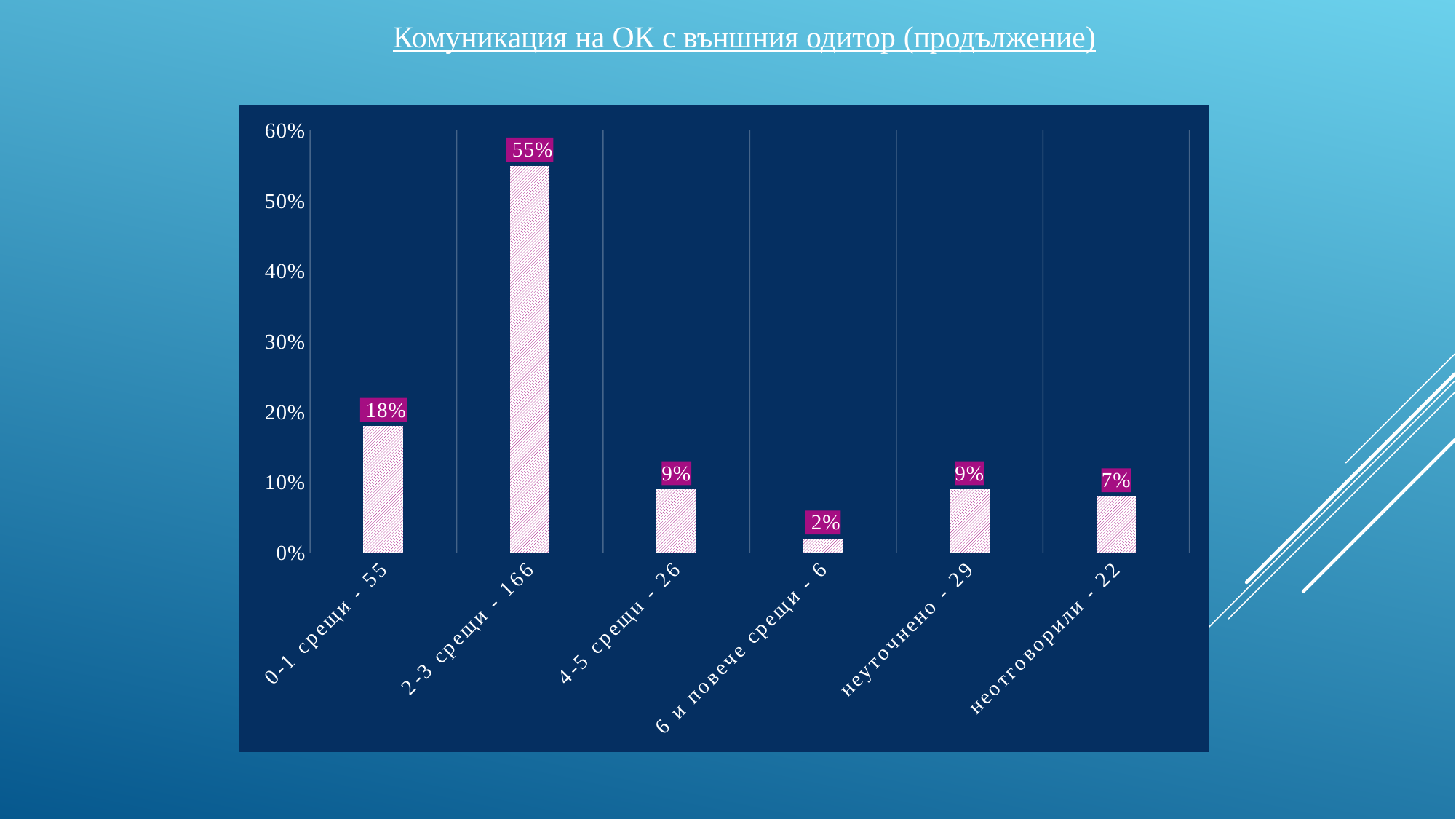
What is the value for the category "2-3 срещи - 166"? 55% What kind of chart is shown on the slide? bar chart What is the value for the category "6 и повече срещи - 6"? 2% Which category has the highest value? 2-3 срещи - 166 Is the value for "2-3 срещи - 166" greater or less than 50%? greater What is the value for the category "неотговорили - 22"? 7% Which category has the lowest value? 6 и повече срещи - 6 What is the title of the slide? Комуникация на ОК с външния одитор (продължение) Which is larger, the value for "0-1 срещи - 55" or the value for "4-5 срещи - 26"? 0-1 срещи - 55 What is the value for the category "0-1 срещи - 55"? 18% What is the difference between the values for "2-3 срещи - 166" and "0-1 срещи - 55"? 37% How many categories are shown on the x axis? 6